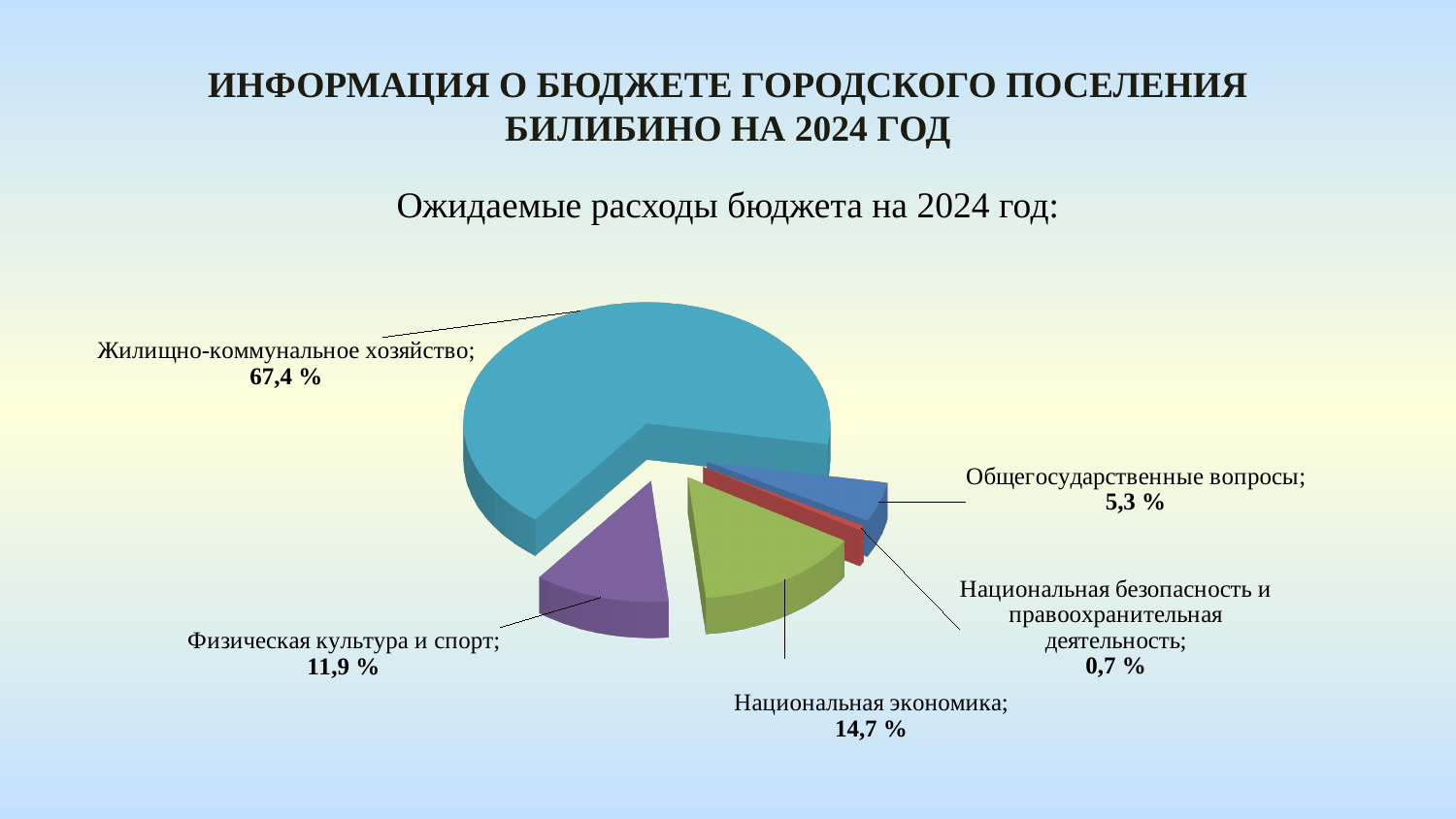
What is the difference in percentage points between Национальная экономика and Физическая культура и спорт? 2,8 What type of chart is shown on the slide? Pie chart What percentage is shown for Общегосударственные вопросы? 5,3 % What percentage is shown for Национальная экономика? 14,7 % What is the subtitle above the chart? Ожидаемые расходы бюджета на 2024 год: Which category has the largest share of the pie? Жилищно-коммунальное хозяйство What is the combined share of Национальная экономика and Общегосударственные вопросы? 20,0 % Which is larger: the share for Общегосударственные вопросы or the share for Физическая культура и спорт? Физическая культура и спорт How many categories are shown in the pie chart? 5 Which category has the smallest share of the pie? Национальная безопасность и правоохранительная деятельность What share of expected 2024 budget expenditures goes to Жилищно-коммунальное хозяйство? 67,4 % What percentage is shown for Физическая культура и спорт? 11,9 %